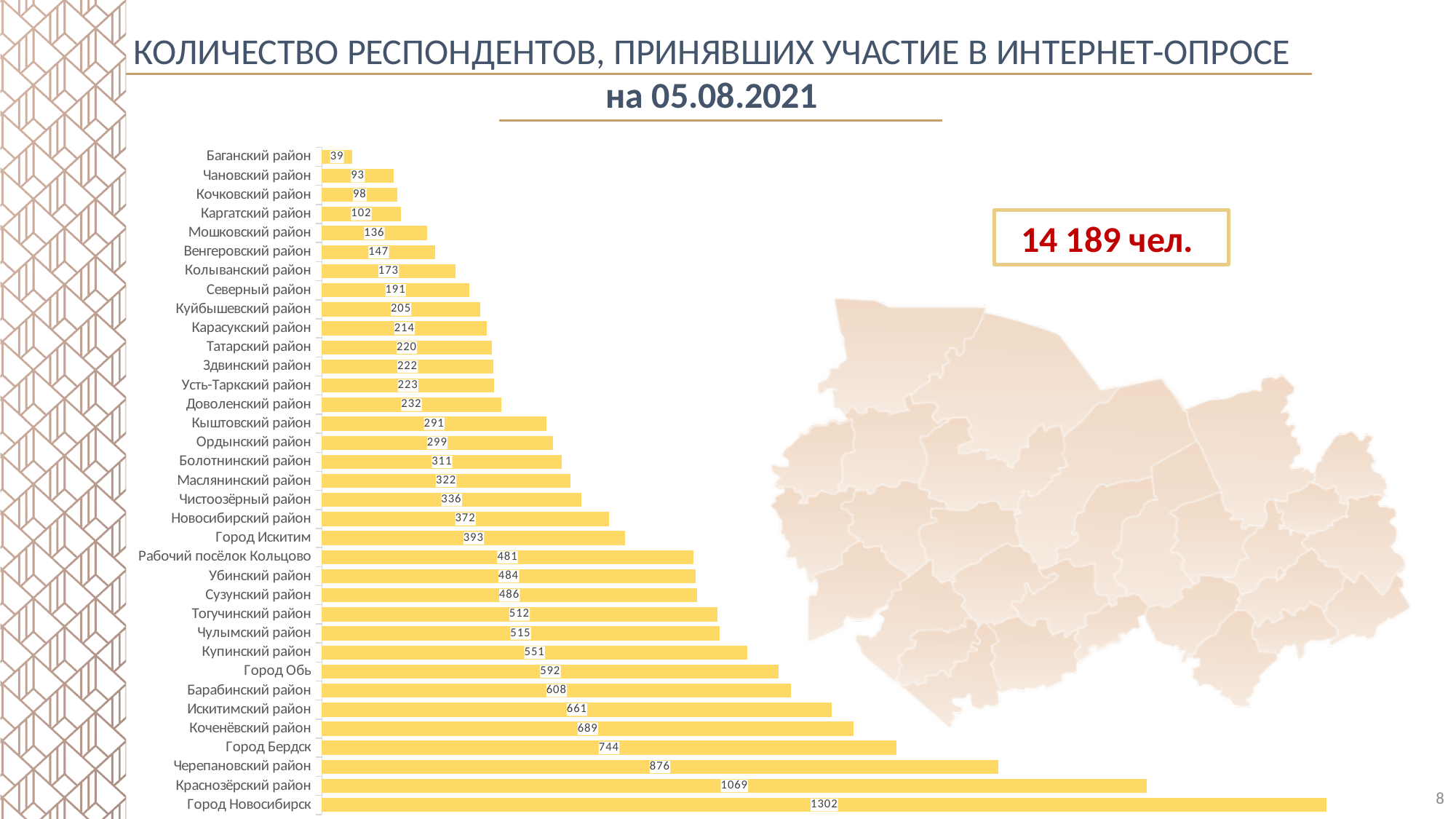
What is the value for Черепановский район? 876 What date is given in the chart title? 05.08.2021 How many categories are plotted on the chart? 35 What is the difference between the values for Краснозёрский район and Город Бердск? 325 Which category has the lowest value? Баганский район What is the value for Рабочий посёлок Кольцово? 481 Which category has the highest value? Город Новосибирск What kind of chart is shown on the slide? Bar chart How many respondents are shown for Город Новосибирск? 1302 Which is larger, the value for Купинский район or the value for Город Обь? Город Обь What is the value for Мошковский район? 136 What total number of respondents is shown in the box on the slide? 14 189 чел.